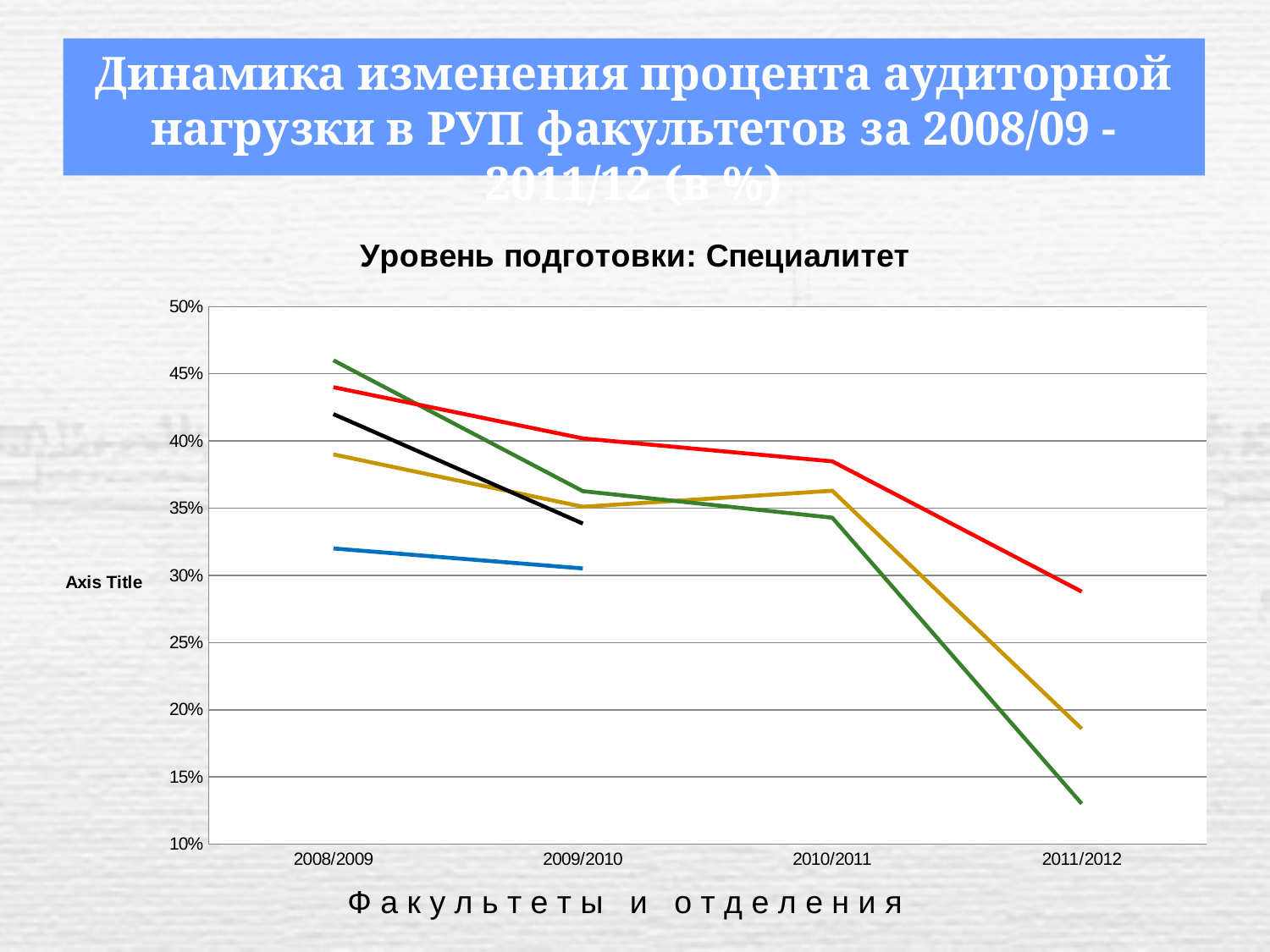
Is the value of the green line for 2008/2009 greater or less than 45%? greater Does the red line rise or fall from 2008/2009 to 2011/2012? fall What is the subtitle printed above the chart? Уровень подготовки: Специалитет Which line has the highest value at 2011/2012? the red line Is the value of the blue line for 2008/2009 greater or less than 30%? greater Which line has the lowest value at 2008/2009? the blue line Is the value of the green line for 2011/2012 greater or less than 15%? less How many lines are plotted on the chart? 5 What kind of chart is shown on the slide? line chart At 2011/2012, which is higher: the red line or the green line? the red line How many academic years are shown on the x axis of the chart? 4